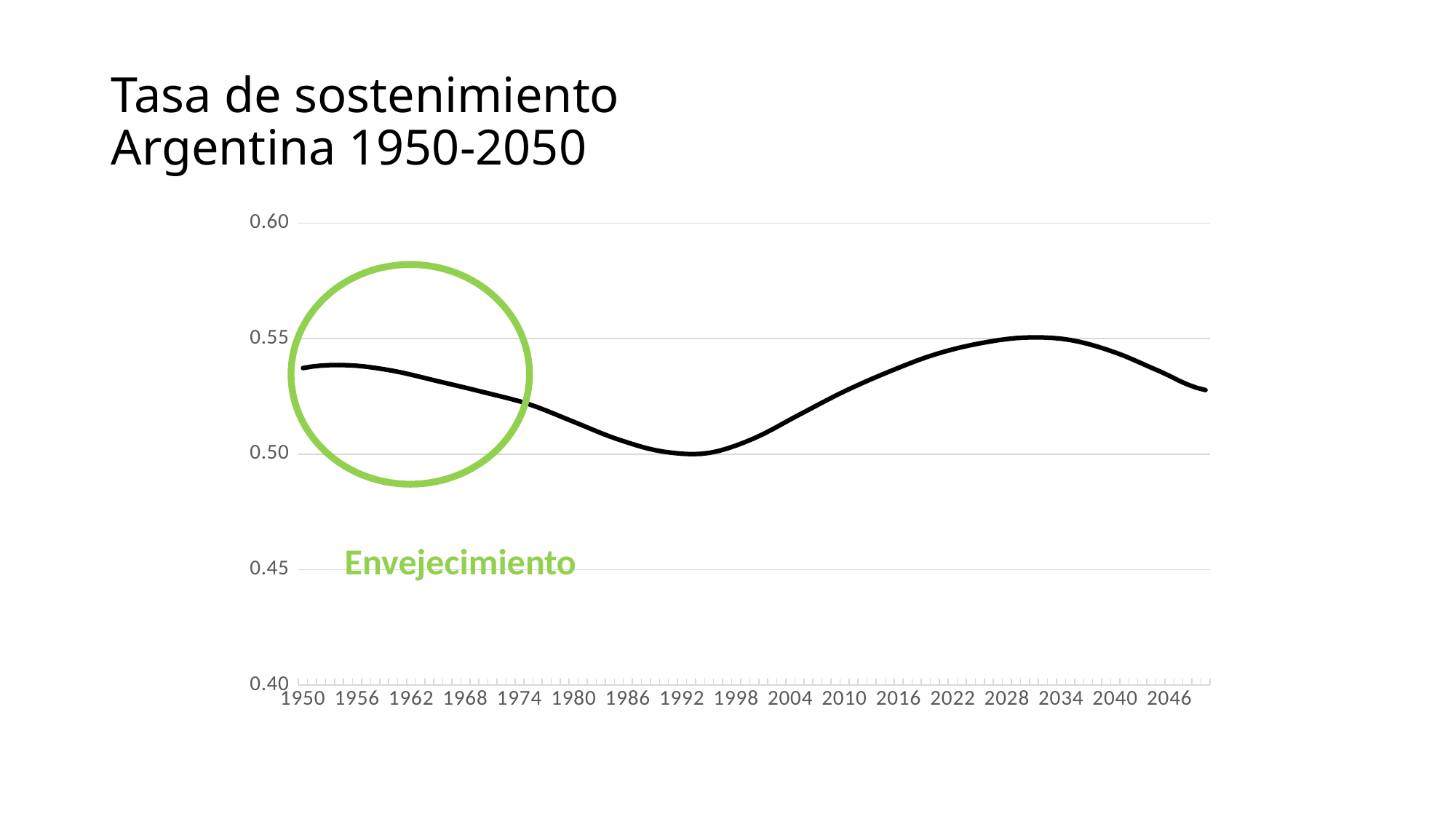
What word is written in green below the circled part of the line? Envejecimiento What kind of chart is shown on the slide? line chart Is the value for 1974 greater or less than 0.50? greater Which is larger, the value for 1950 or the value for 1992? 1950 Is the value for 2046 greater or less than 0.50? greater Is the value for 1950 greater or less than 0.55? less Does the line rise or fall between 1950 and 1992? fall Does the line rise or fall between 1992 and 2028? rise What is the title of the chart on the slide? Tasa de sostenimiento Argentina 1950-2050 Which is larger, the value for 2030 or the value for 1992? 2030